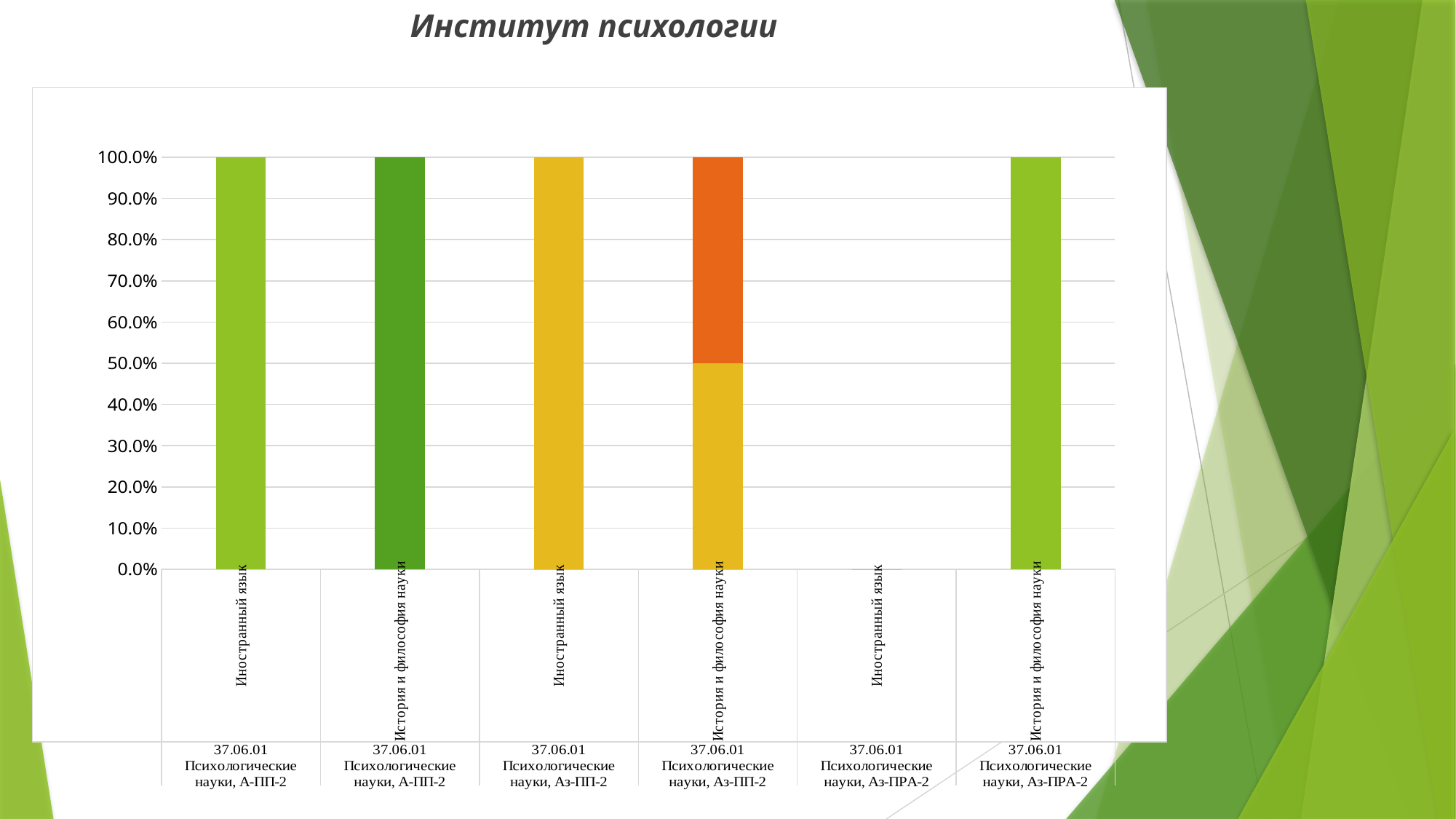
Is the value for Иностранный язык, 37.06.01 Психологические науки, Аз-ПП-2 greater or less than 50.0%? greater How many categories are shown along the x axis of the chart? 6 What is the total height of the stacked bar for История и философия науки, 37.06.01 Психологические науки, Аз-ПП-2? 100.0% What is the value of the bar for Иностранный язык, 37.06.01 Психологические науки, Аз-ПРА-2? 0.0% What is the value of the bar for Иностранный язык, 37.06.01 Психологические науки, А-ПП-2? 100.0% Which bar in the chart is split into two differently coloured segments? История и философия науки, 37.06.01 Психологические науки, Аз-ПП-2 Which is larger: the bar for Иностранный язык, Аз-ПРА-2 or the bar for История и философия науки, Аз-ПРА-2? История и философия науки, Аз-ПРА-2 Which category has the lowest bar in the chart? Иностранный язык, 37.06.01 Психологические науки, Аз-ПРА-2 What is the title of the slide? Институт психологии What is the value of the lower (yellow) segment of the bar for История и философия науки, 37.06.01 Психологические науки, Аз-ПП-2? 50.0% What is the value of the bar for История и философия науки, 37.06.01 Психологические науки, Аз-ПРА-2? 100.0% What kind of chart is shown on the slide? bar chart